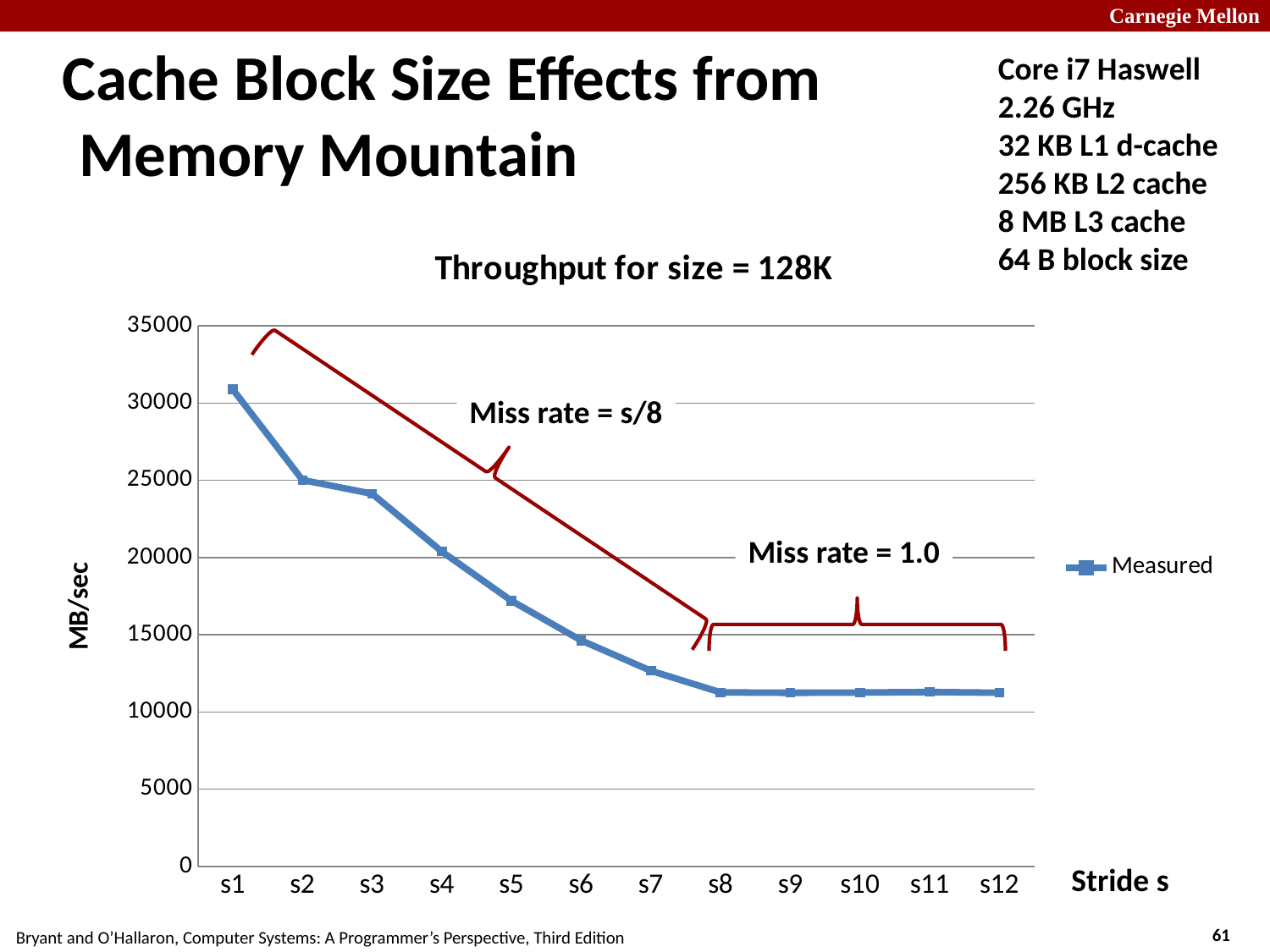
Is the measured value for s5 greater or less than 15000? greater Is the measured value for s3 greater or less than 25000? less How many stride categories are plotted along the x axis? 12 Which stride has the highest measured throughput? s1 How many series does the legend list? 1 Is the measured value for s7 greater or less than 15000? less What kind of chart is shown on the slide? Line chart Which has the larger measured throughput, s3 or s7? s3 What is the title of the chart? Throughput for size = 128K What is the name of the series shown in the legend? Measured